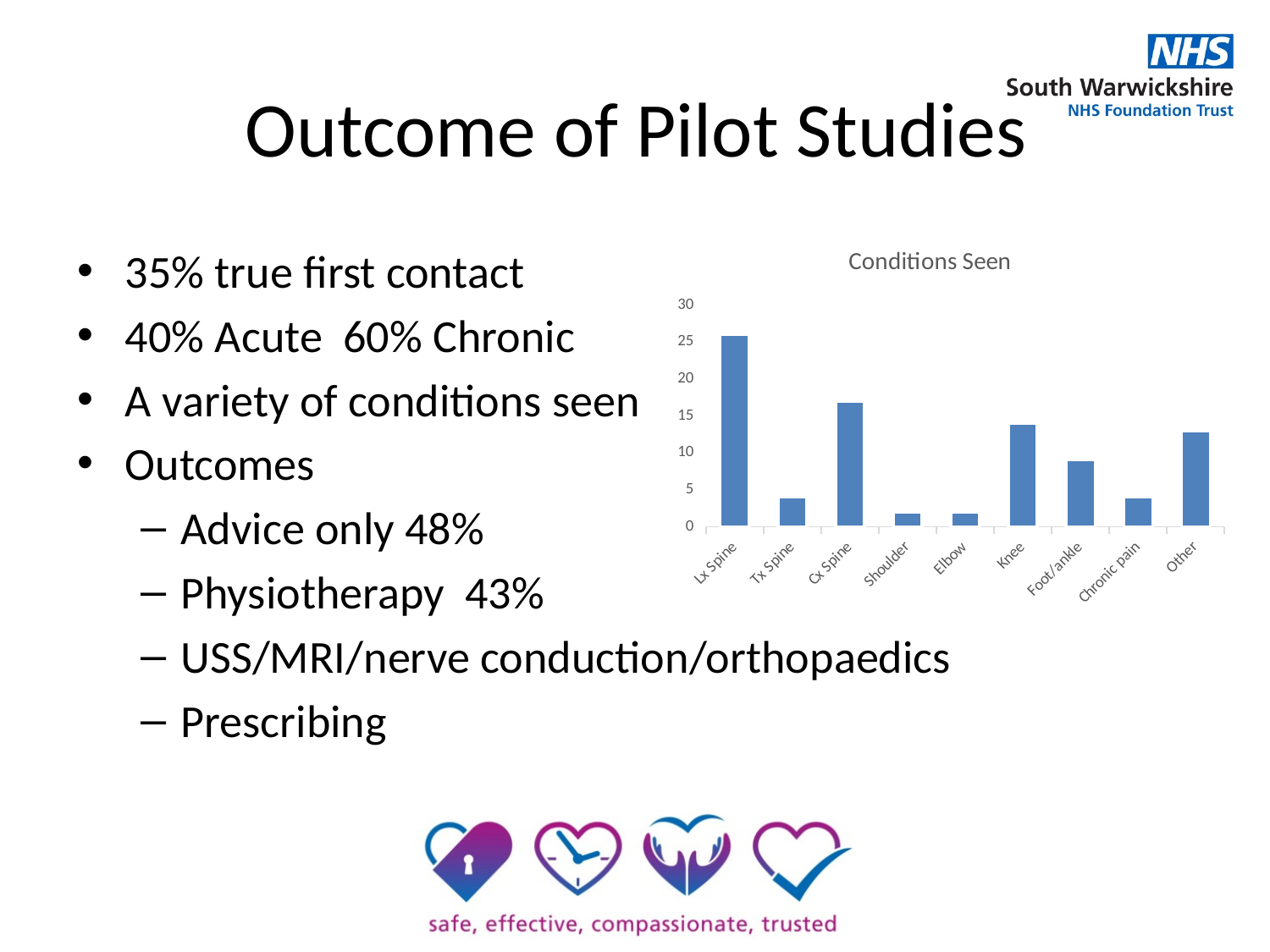
How many conditions (categories) are shown on the x axis of the chart? 9 Is the value for Lx Spine greater or less than 20? greater Is the value for Foot/ankle greater or less than 10? less Which has the larger value, Cx Spine or Knee? Cx Spine What is the title of the chart? Conditions Seen Is the value for Knee greater or less than 10? greater Which condition has the highest bar in the chart? Lx Spine Which has the larger value, Foot/ankle or Chronic pain? Foot/ankle What kind of chart is shown on the slide? bar chart